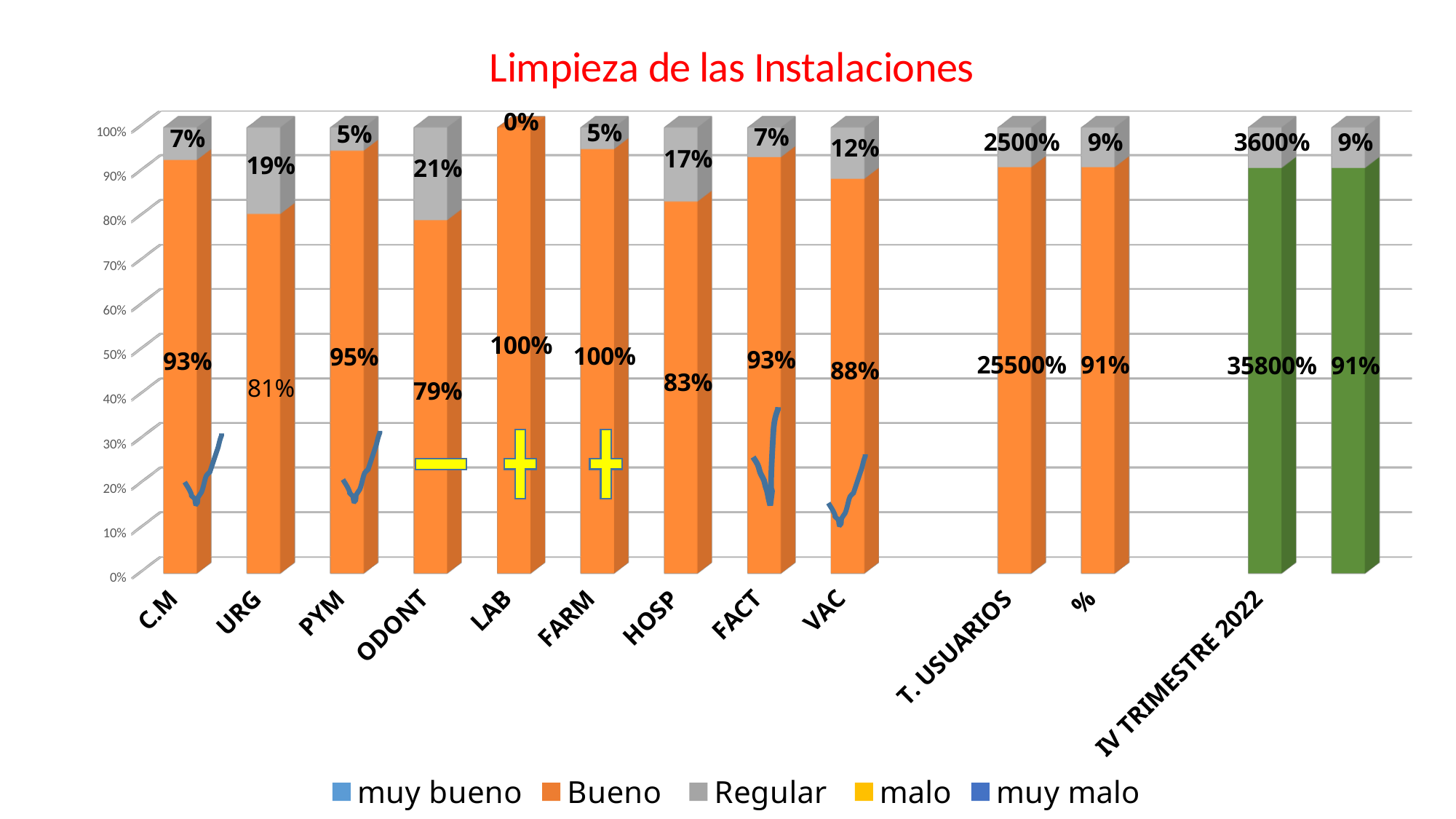
What is the Bueno value for ODONT? 79% What is the Regular value for URG? 19% Among the departments C.M through VAC, which has the lowest Bueno value? ODONT What is the Regular value for LAB? 0% What is the difference between the Bueno value for PYM and the Bueno value for HOSP? 12 percentage points Which has a higher Bueno value, C.M or URG? C.M What is the Regular value for HOSP? 17% What kind of chart is shown on the slide? Stacked bar chart What is the Bueno value for VAC? 88% What is the title of the chart? Limpieza de las Instalaciones How many series does the legend list? 5 Among the departments C.M through VAC, which has the highest Regular value? ODONT